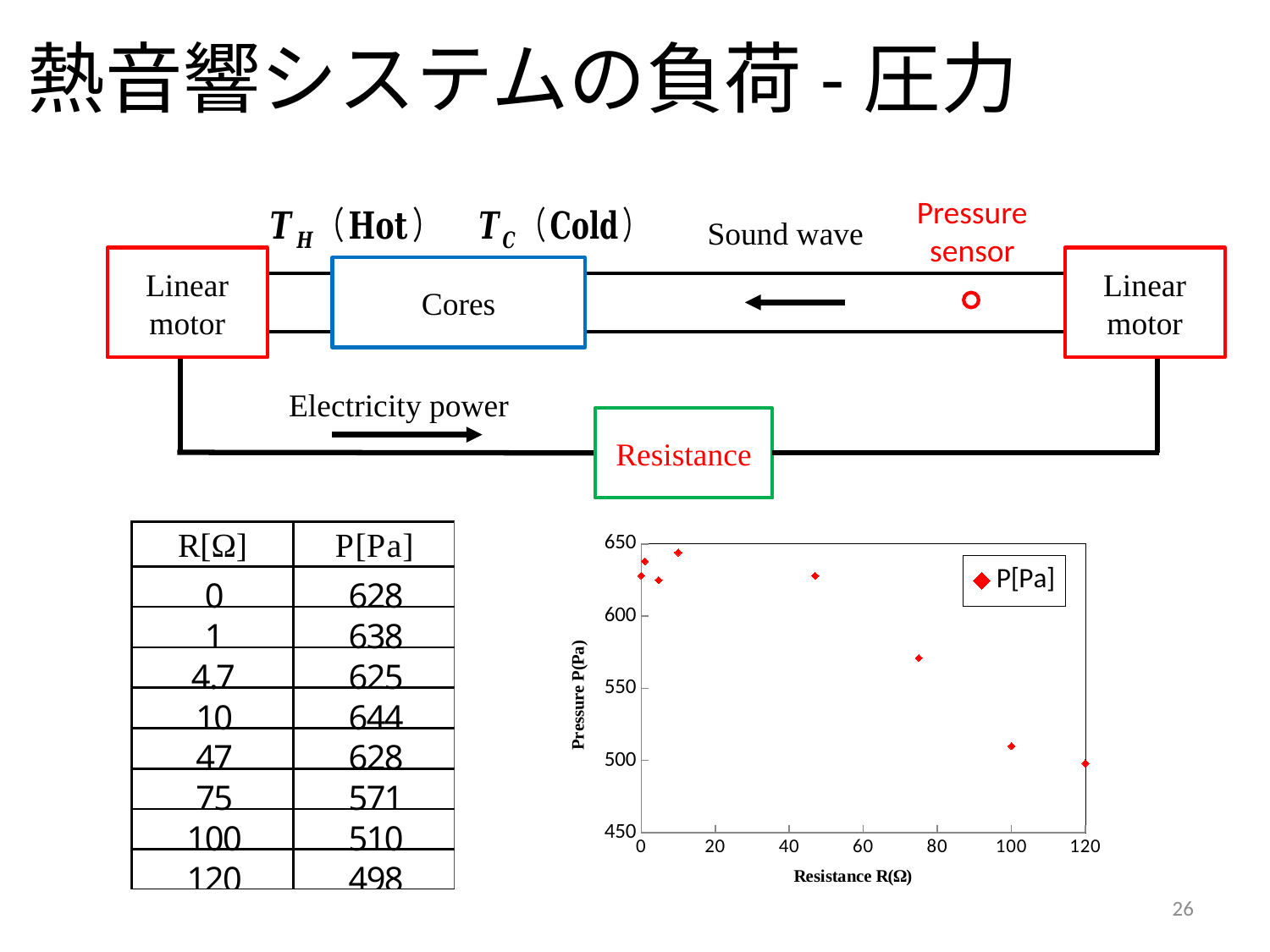
What is the pressure P[Pa] at a resistance of 100 Ω? 510 How many series does the chart legend list? 1 What is the name of the series shown in the chart legend? P[Pa] How many data points are plotted in the chart? 8 What is the pressure P[Pa] at a resistance of 75 Ω? 571 Which has the larger pressure, R = 75 Ω or R = 100 Ω? 75 Ω Overall, does the pressure rise or fall as resistance increases along the x axis? fall At which resistance value is the pressure highest? 10 What is the title of the chart's x axis? Resistance R(Ω) What is the difference in pressure between R = 0 Ω and R = 120 Ω? 130 What kind of chart is shown on the slide? scatter chart At which resistance value is the pressure lowest? 120